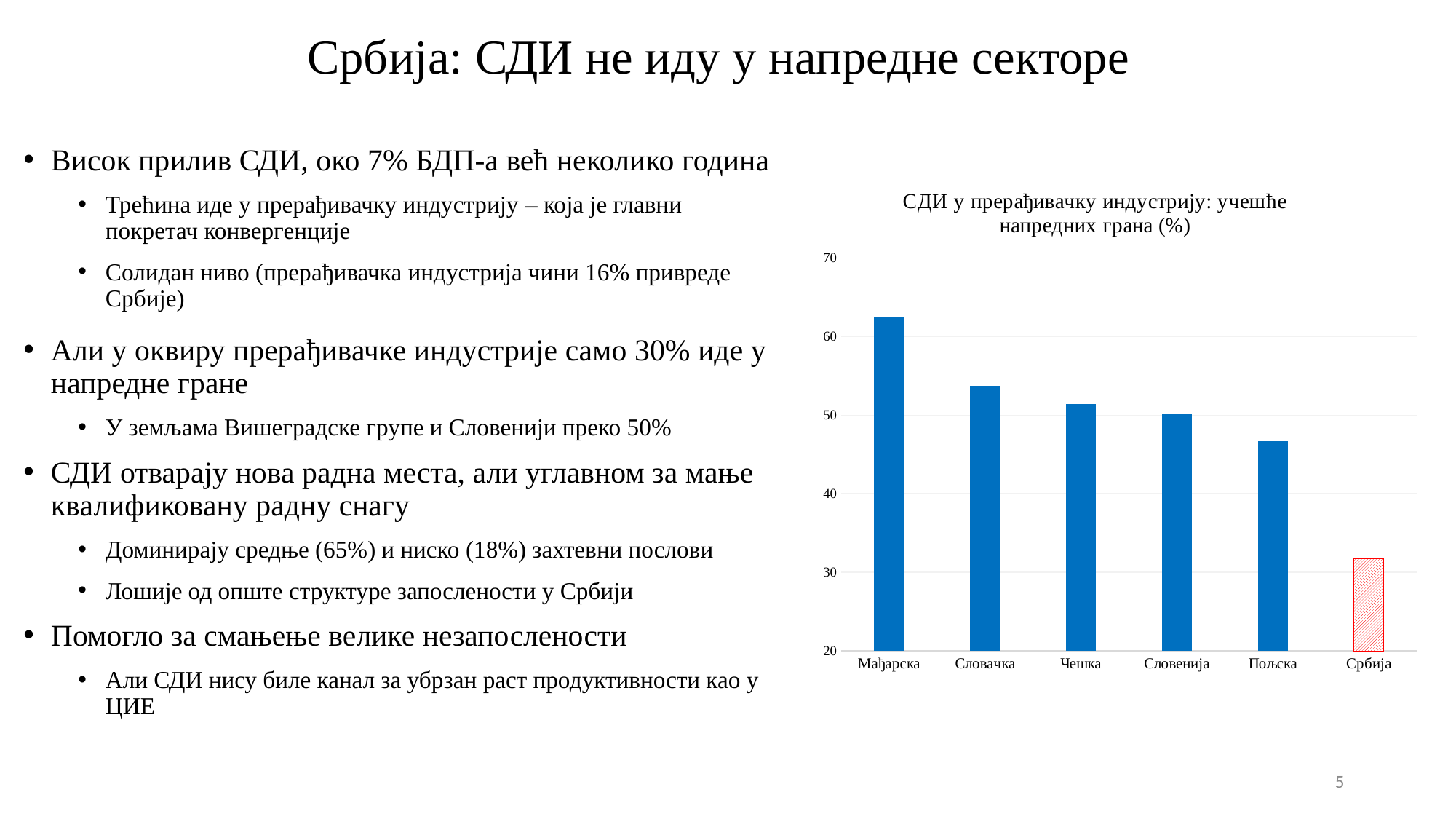
Is the value for Србија greater or less than 40? less How many countries are shown in the chart? 6 What is the title of the chart? СДИ у прерађивачку индустрију: учешће напредних грана (%) Which has a larger value, Мађарска or Словачка? Мађарска What kind of chart is shown on the slide? bar chart Which country has the highest value in the chart? Мађарска Which country has the lowest value in the chart? Србија Is the value for Мађарска greater or less than 60? greater Is the value for Пољска greater or less than 50? less Which has a larger value, Пољска or Србија? Пољска Do the values rise or fall from left to right across the chart? fall